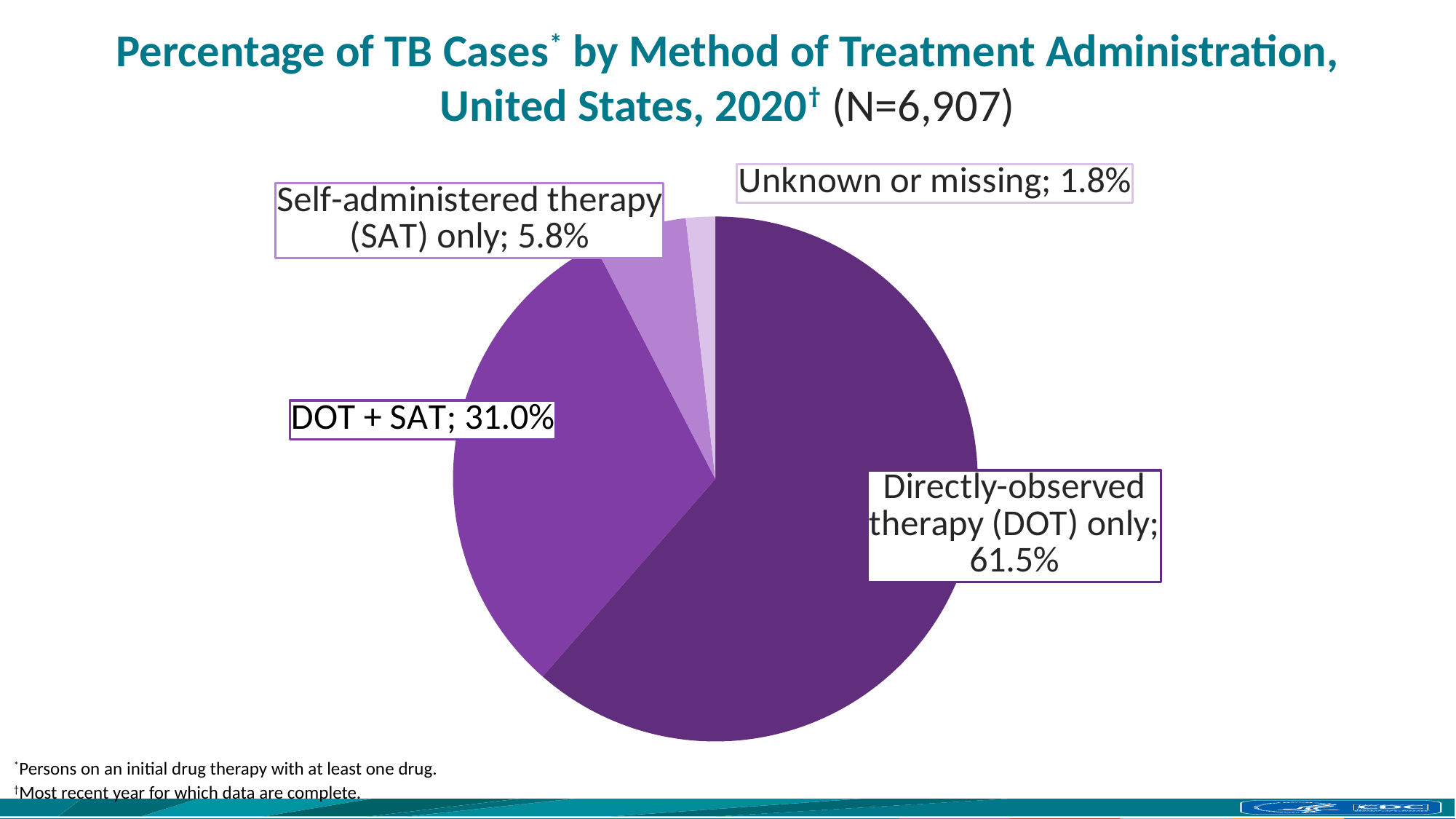
What percentage of TB cases have an unknown or missing method of treatment administration? 1.8% How many categories are shown in the pie chart? 4 What percentage of TB cases were treated with directly-observed therapy (DOT) only? 61.5% What kind of chart is shown on the slide? Pie chart What is the total number of TB cases (N) given in the chart title? 6,907 What percentage of TB cases were treated with self-administered therapy (SAT) only? 5.8% What percentage of TB cases were treated with DOT + SAT? 31.0% What is the difference in percentage points between DOT only and DOT + SAT? 30.5 What year does the chart's data refer to? 2020 Which method of treatment administration accounts for the largest share of TB cases? Directly-observed therapy (DOT) only Which is larger: the share for SAT only or the share for Unknown or missing? SAT only Which category accounts for the smallest share of TB cases? Unknown or missing